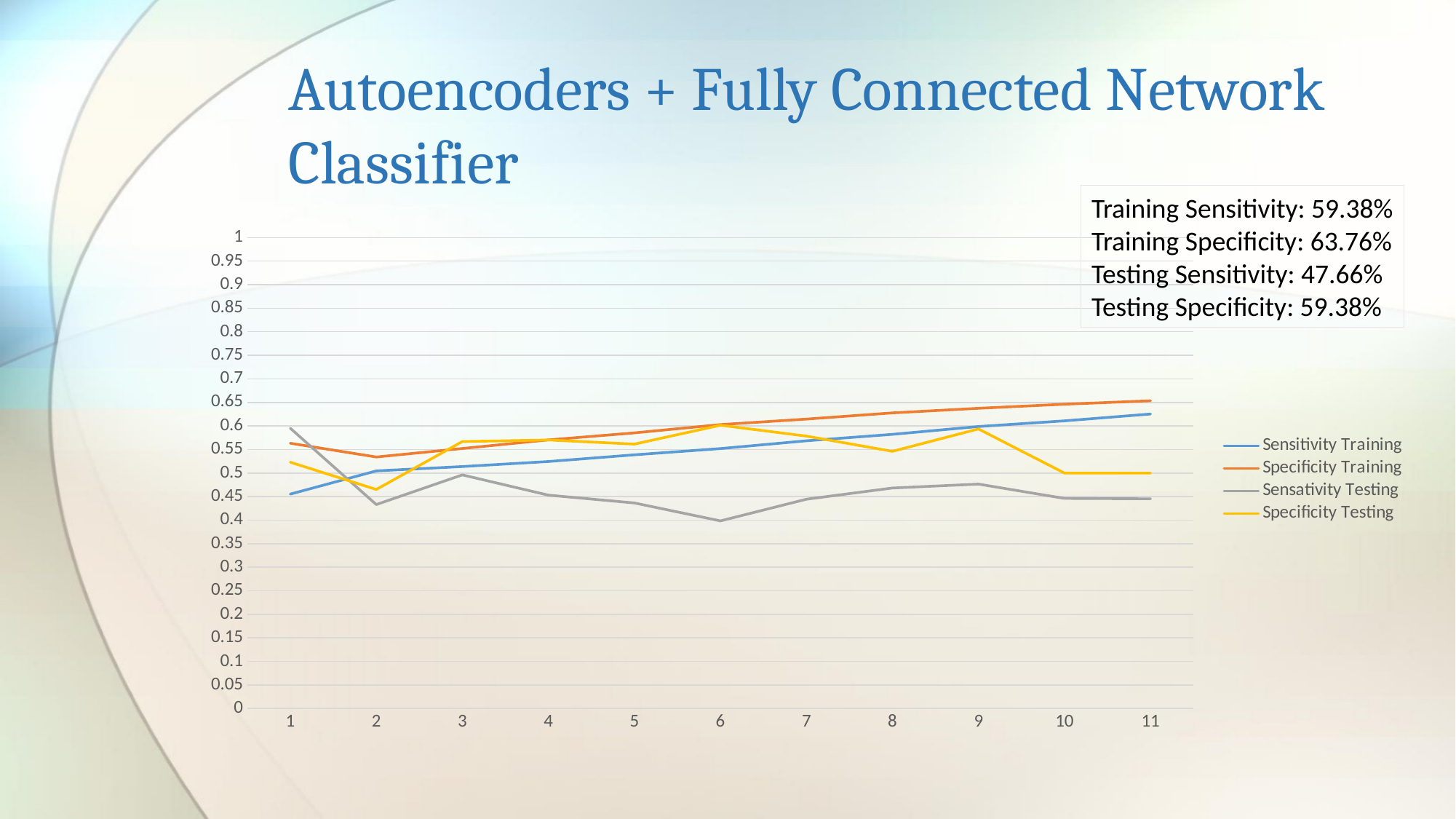
At point 11, which series has the highest value? Specificity Training How many series does the chart's legend list? 4 What colour is the Specificity Testing line in the legend? Yellow Does the Sensitivity Training series rise or fall from point 1 to point 11? Rises How many points are plotted along the x axis for each series? 11 At point 6, which is larger: Specificity Testing or Sensativity Testing? Specificity Testing Is the value of Sensativity Testing at point 2 greater or less than 0.5? less What kind of chart is shown on the slide? Line chart Is the value of Specificity Testing at point 1 greater or less than 0.5? greater Is the value of Sensitivity Training at point 11 greater or less than 0.6? greater At point 11, which series has the lowest value? Sensativity Testing At which x-axis point does the Sensativity Testing series reach its lowest value? 6